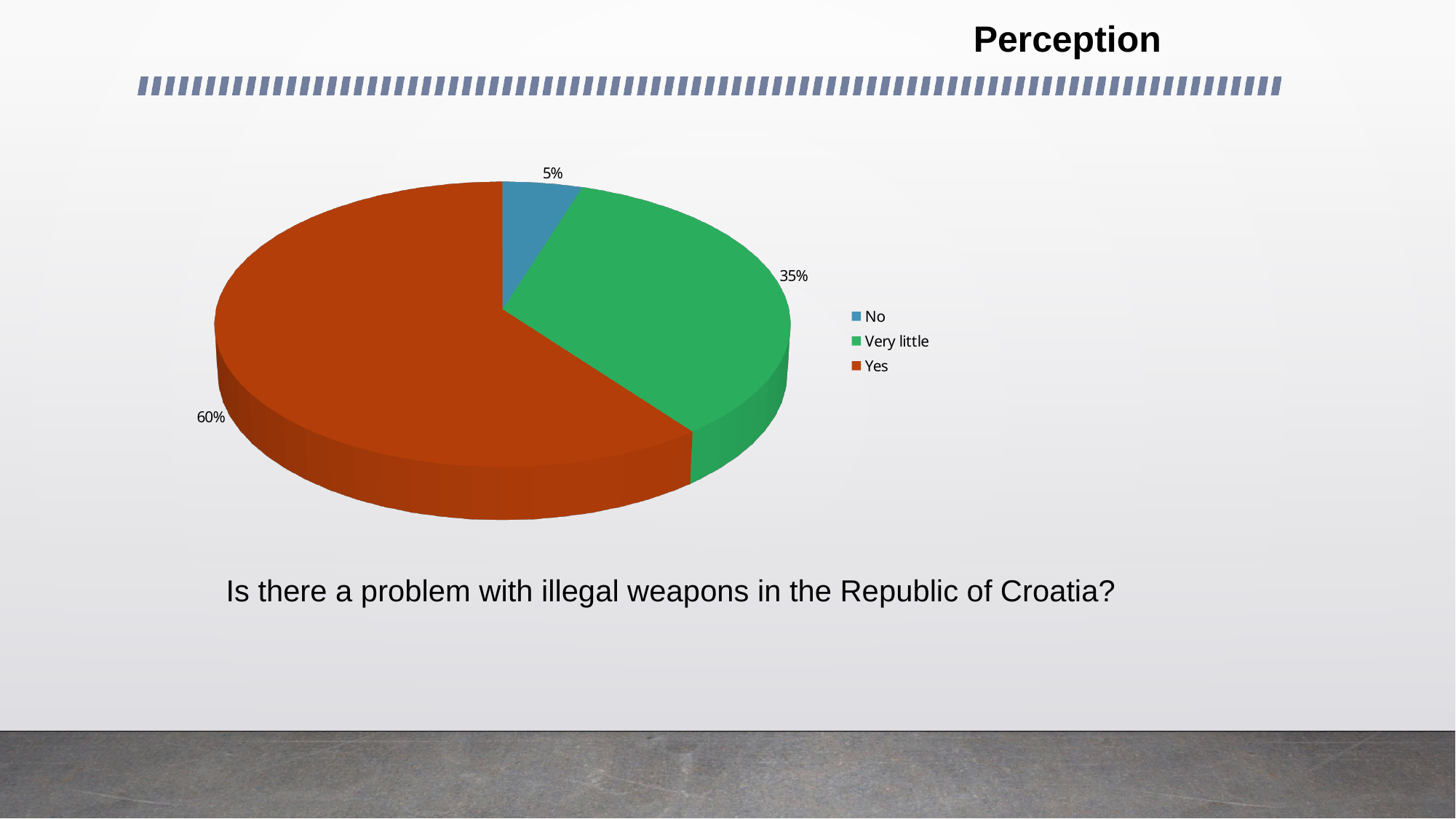
What percentage of respondents answered "No"? 5% What percentage of respondents answered "Yes"? 60% Which response has the smallest share of the pie? No What is the difference in percentage points between "Yes" and "Very little"? 25 How many categories does the pie chart show? 3 What question does the pie chart present responses to? Is there a problem with illegal weapons in the Republic of Croatia? What percentage of respondents answered "Very little"? 35% Which response has the largest share of the pie? Yes What is the difference in percentage points between "Very little" and "No"? 30 Which is larger, the share for "Very little" or the share for "No"? Very little What kind of chart is shown on the slide? Pie chart What colour is the "Yes" slice in the pie chart? Red